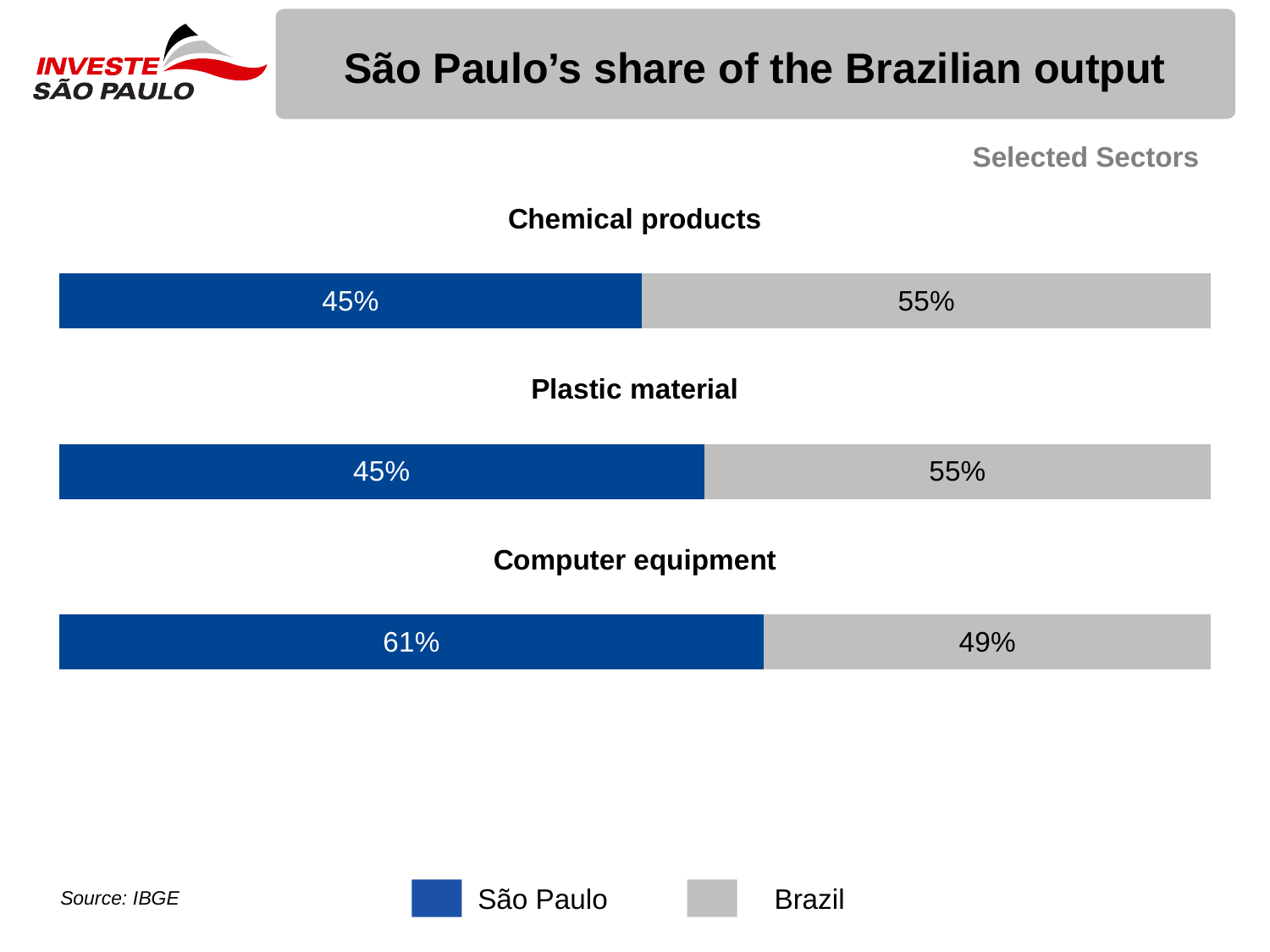
What kind of chart is used for each sector on this slide? Bar chart In the Computer equipment chart, what is the difference between the São Paulo value and the Brazil value? 12 percentage points In the Chemical products chart, how much larger is the Brazil value than the São Paulo value? 10 percentage points In the Chemical products chart, what is the value for Brazil? 55% In the Plastic material chart, what is São Paulo's share? 45% In the Chemical products chart, what is São Paulo's share? 45% Across the three sector charts, which sector shows the highest São Paulo share? Computer equipment In the Computer equipment chart, which is larger, the São Paulo value or the Brazil value? São Paulo In the Computer equipment chart, what is São Paulo's share? 61% In the Computer equipment chart, what is the value for Brazil? 49% How many sectors are shown on the slide? 3 How many series does the legend at the bottom of the slide list? 2